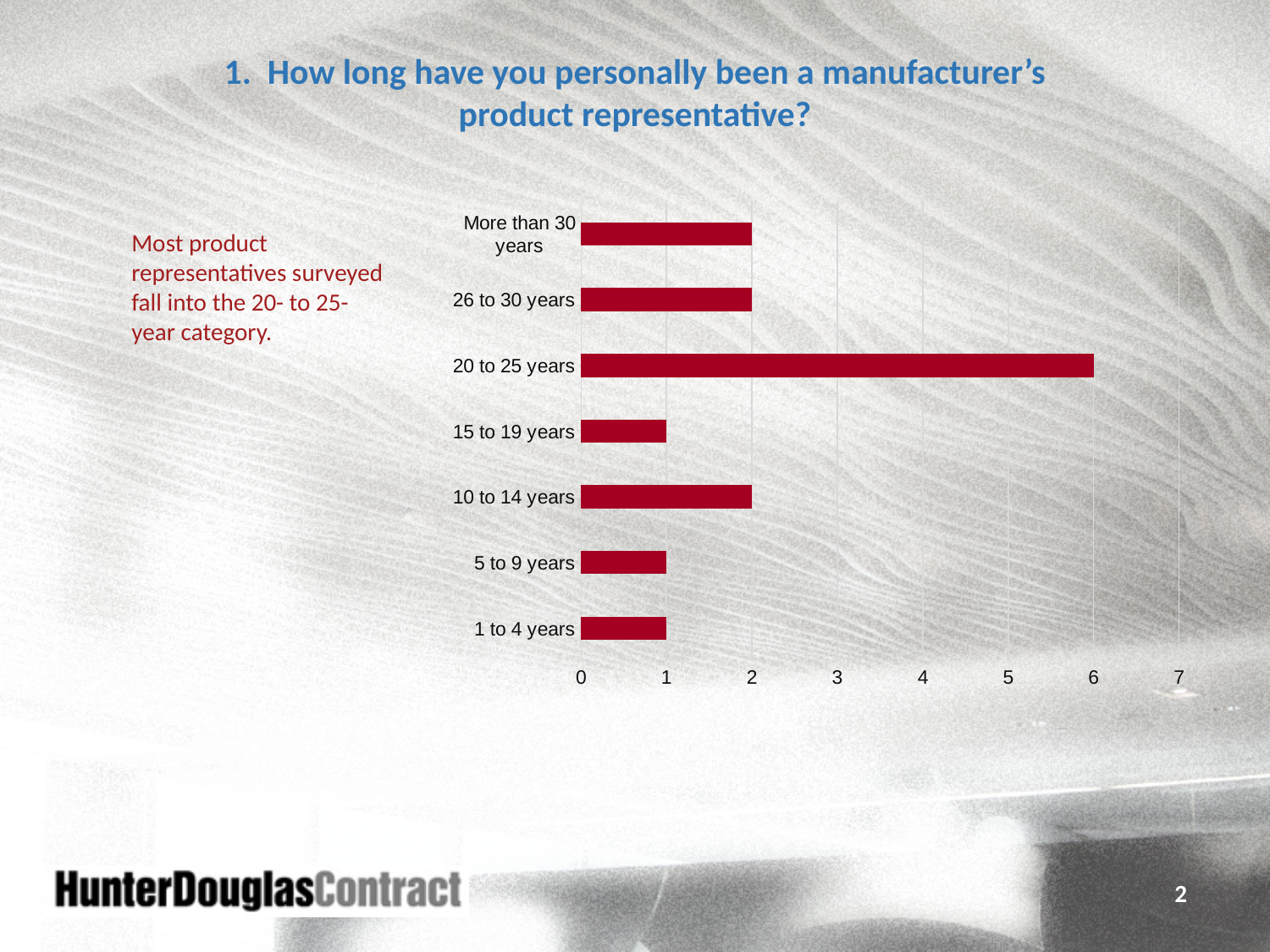
What colour are the bars in the chart? red Which is larger, the value for 10 to 14 years or the value for 5 to 9 years? 10 to 14 years What is the value for 26 to 30 years? 2 Which category has the highest value? 20 to 25 years What is the value for 10 to 14 years? 2 Is the value for 20 to 25 years greater or less than 5? greater What is the difference between the values for 20 to 25 years and 26 to 30 years? 4 What is the value for 15 to 19 years? 1 What kind of chart is shown on the slide? bar chart How many categories does the chart show? 7 What is the value for 20 to 25 years? 6 What is the highest value shown on the horizontal axis? 7